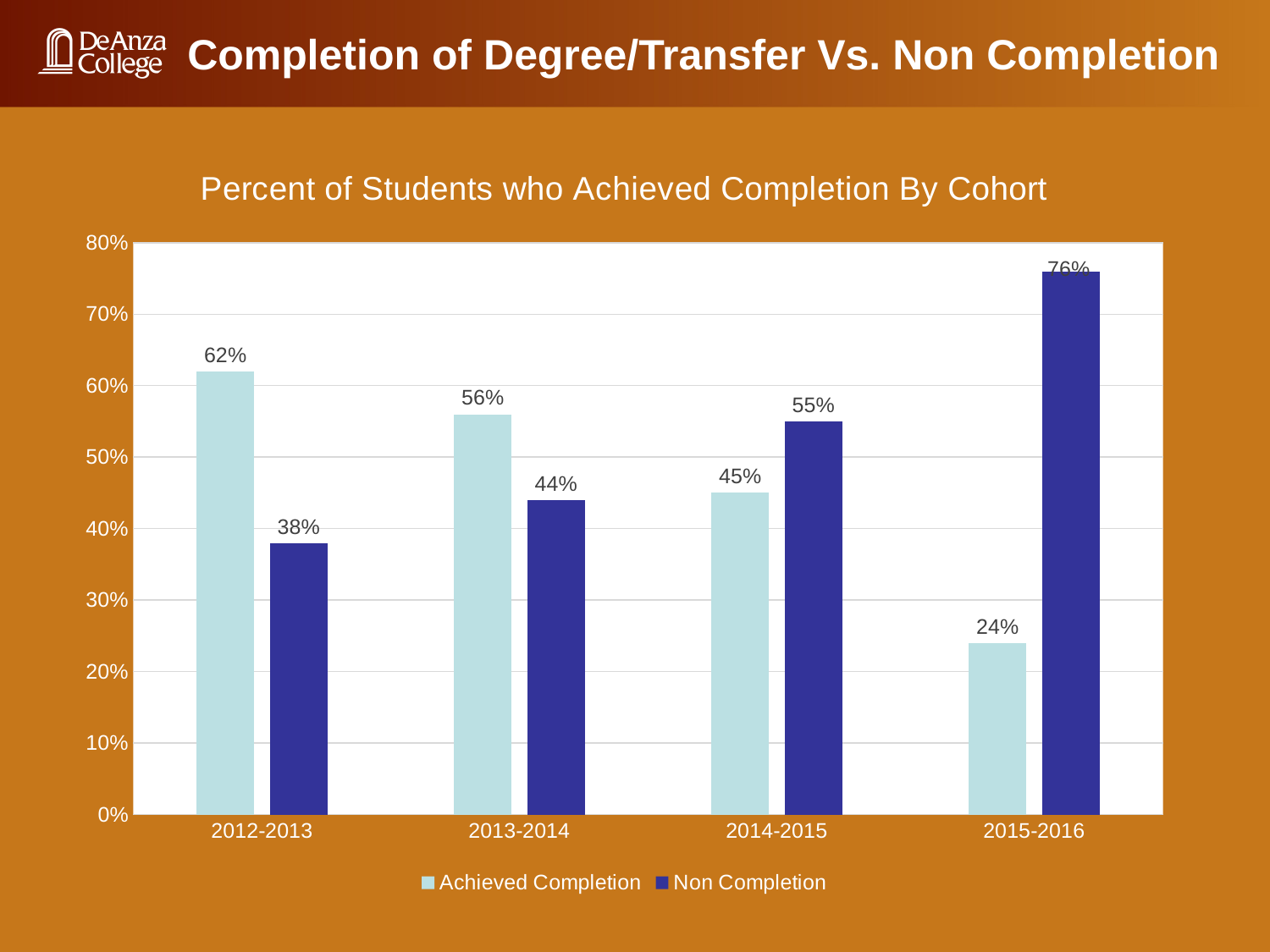
What is the title of the chart? Percent of Students who Achieved Completion By Cohort Does the Achieved Completion percentage rise or fall across the cohorts from 2012-2013 to 2015-2016? Fall Which cohort has the highest Achieved Completion percentage? 2012-2013 What percent of students achieved completion in the 2012-2013 cohort? 62% How many series does the legend list? 2 What is the Non Completion value for the 2015-2016 cohort? 76% What is the difference between Achieved Completion and Non Completion for the 2013-2014 cohort? 12% Which is larger for the 2014-2015 cohort, Achieved Completion or Non Completion? Non Completion What kind of chart is shown on the slide? Bar chart What is the Achieved Completion value for the 2014-2015 cohort? 45% Which cohort has the lowest Non Completion percentage? 2012-2013 How many cohorts are shown on the x axis? 4